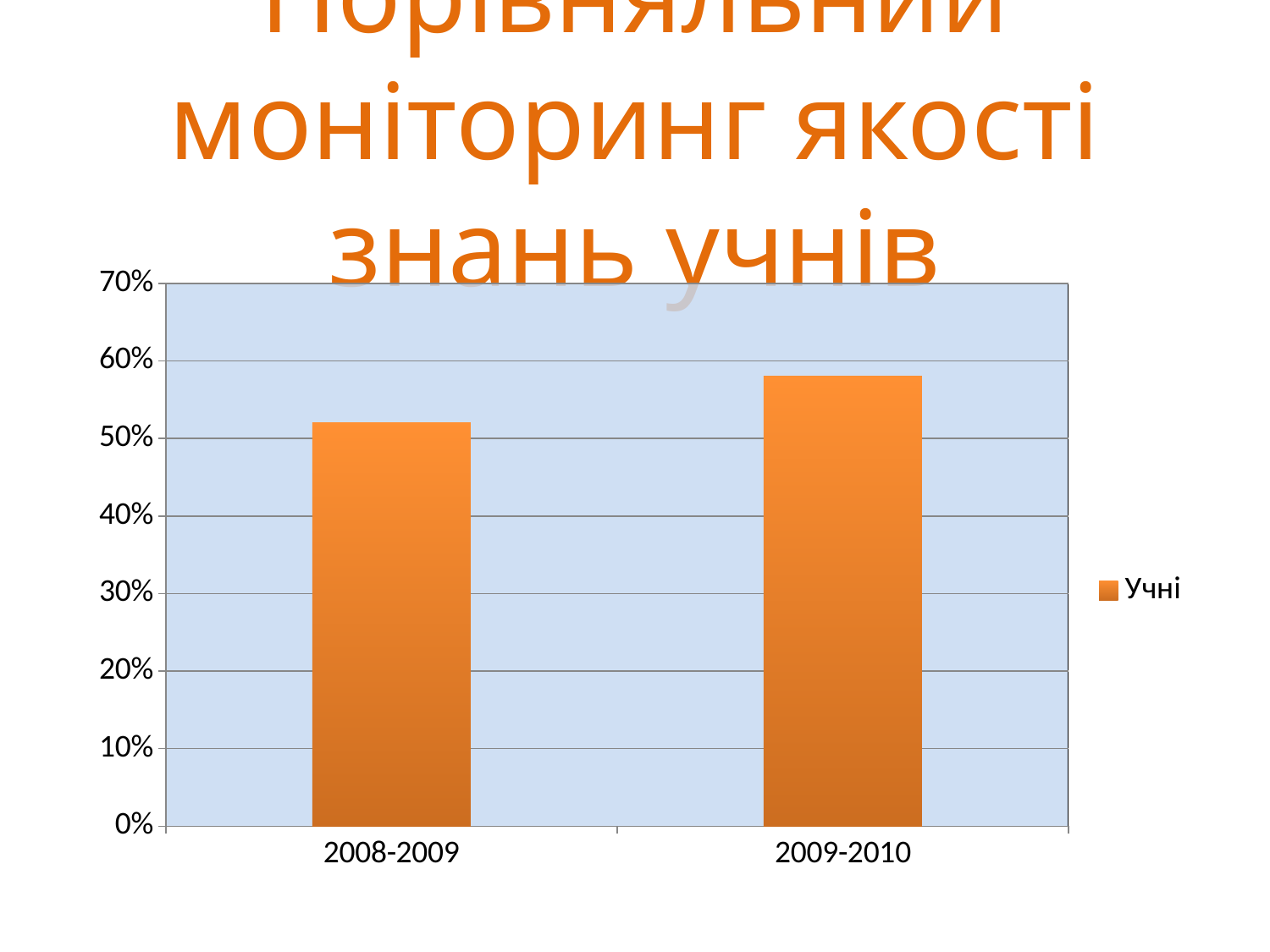
Is the value for 2008-2009 greater or less than 60%? less How many series does the chart's legend list? 1 What is the title of the slide above the chart? Порівняльний моніторинг якості знань учнів Is the value for 2009-2010 greater or less than 60%? less Is the value for 2009-2010 greater or less than 50%? greater Which category has the lowest value in the chart? 2008-2009 How many categories are shown on the x axis of the chart? 2 Do the values rise or fall from 2008-2009 to 2009-2010? rise Which category has the highest value in the chart? 2009-2010 Which is larger, the value for 2008-2009 or the value for 2009-2010? 2009-2010 What kind of chart is shown on the slide? bar chart What is the name of the series listed in the chart's legend? Учні